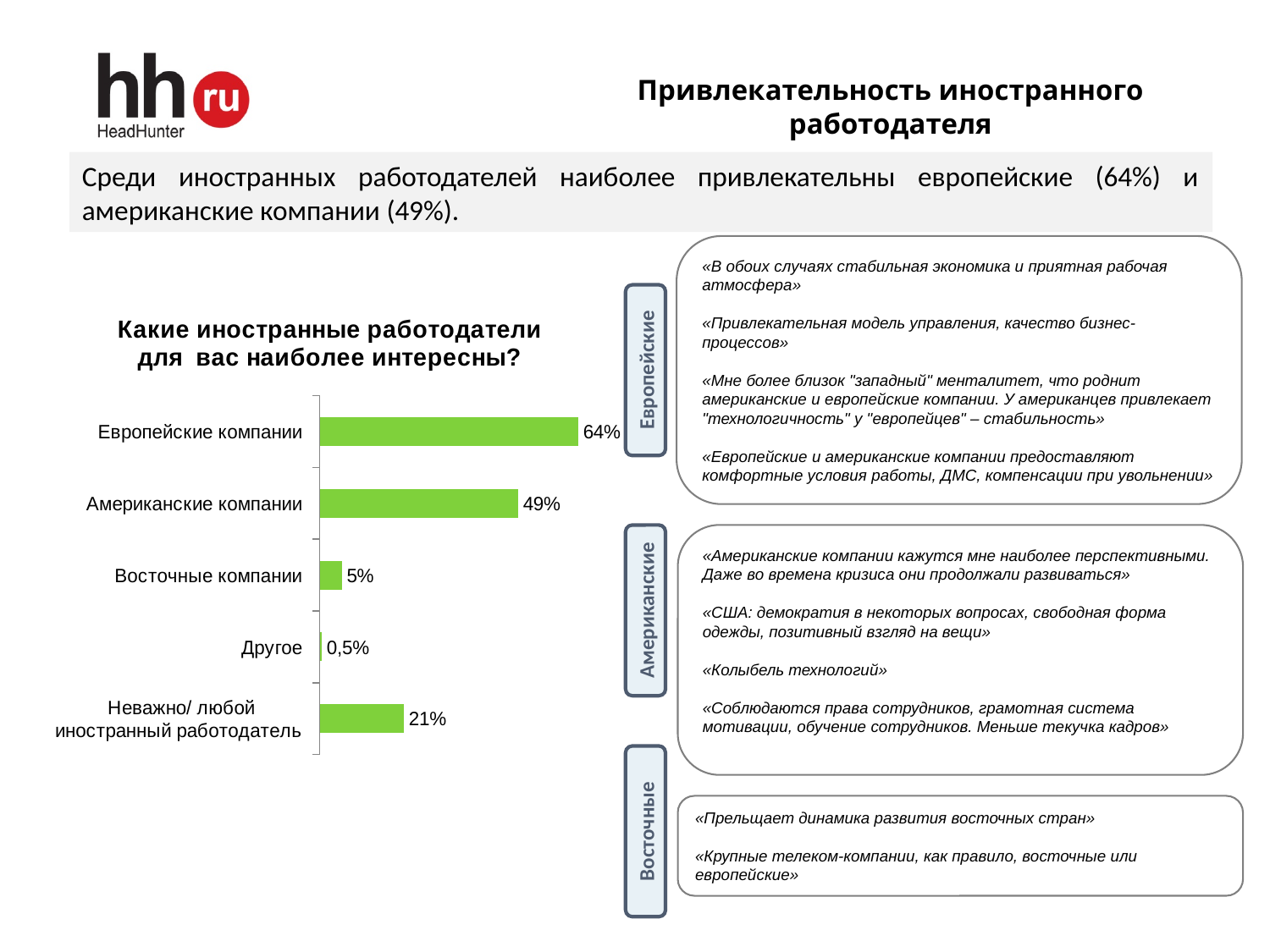
Which category has the highest value? Европейские компании What is the value for Восточные компании? 5% What is the value for Европейские компании? 64% What is the difference between the values for Европейские компании and Американские компании? 15% What is the value for Американские компании? 49% What is the title of the chart? Какие иностранные работодатели для вас наиболее интересны? What is the value for Неважно/ любой иностранный работодатель? 21% Which category has the lowest value? Другое How many categories are shown in the chart? 5 What is the value for Другое? 0,5% Which is larger: the value for Восточные компании or the value for Неважно/ любой иностранный работодатель? Неважно/ любой иностранный работодатель What kind of chart is shown on the slide? Bar chart